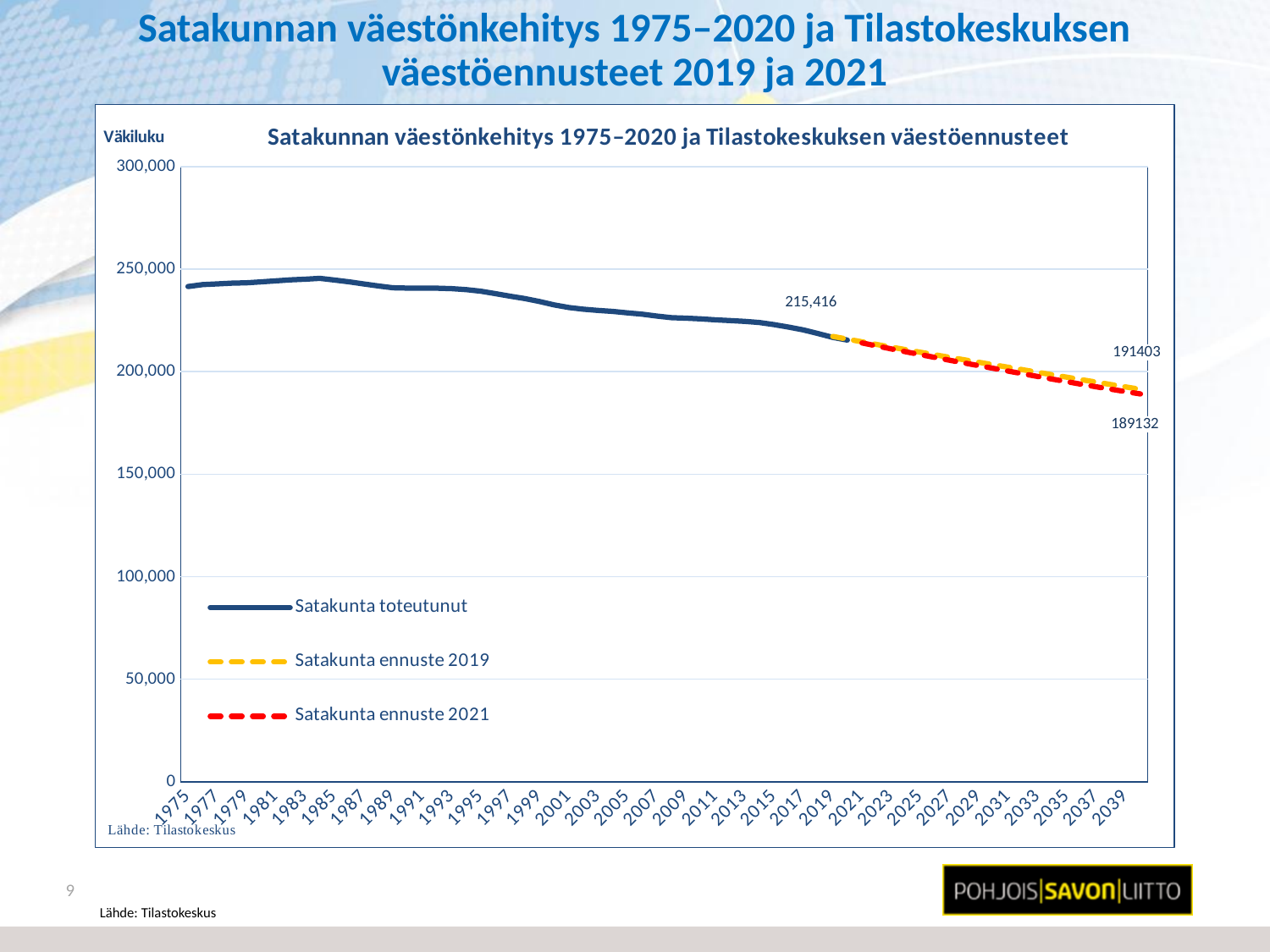
Does the 'Satakunta toteutunut' series rise or fall overall between 1985 and 2020? fall Is the value of 'Satakunta toteutunut' in 1975 greater or less than 200,000? greater What label is shown on the vertical axis of the chart? Väkiluku What value is labelled at the end of the 'Satakunta ennuste 2019' series? 191403 How many series does the chart legend list? 3 Which forecast series ends at a higher value, 'Satakunta ennuste 2019' or 'Satakunta ennuste 2021'? Satakunta ennuste 2019 Is the value of 'Satakunta toteutunut' in 1985 greater or less than 250,000? less What type of chart is shown on the slide? line chart What colour is the dashed line for 'Satakunta ennuste 2021' in the legend? red What value is labelled at the end of the 'Satakunta toteutunut' series? 215,416 What is the difference between the labelled end values of 'Satakunta ennuste 2019' (191403) and 'Satakunta ennuste 2021' (189132)? 2271 What value is labelled at the end of the 'Satakunta ennuste 2021' series? 189132